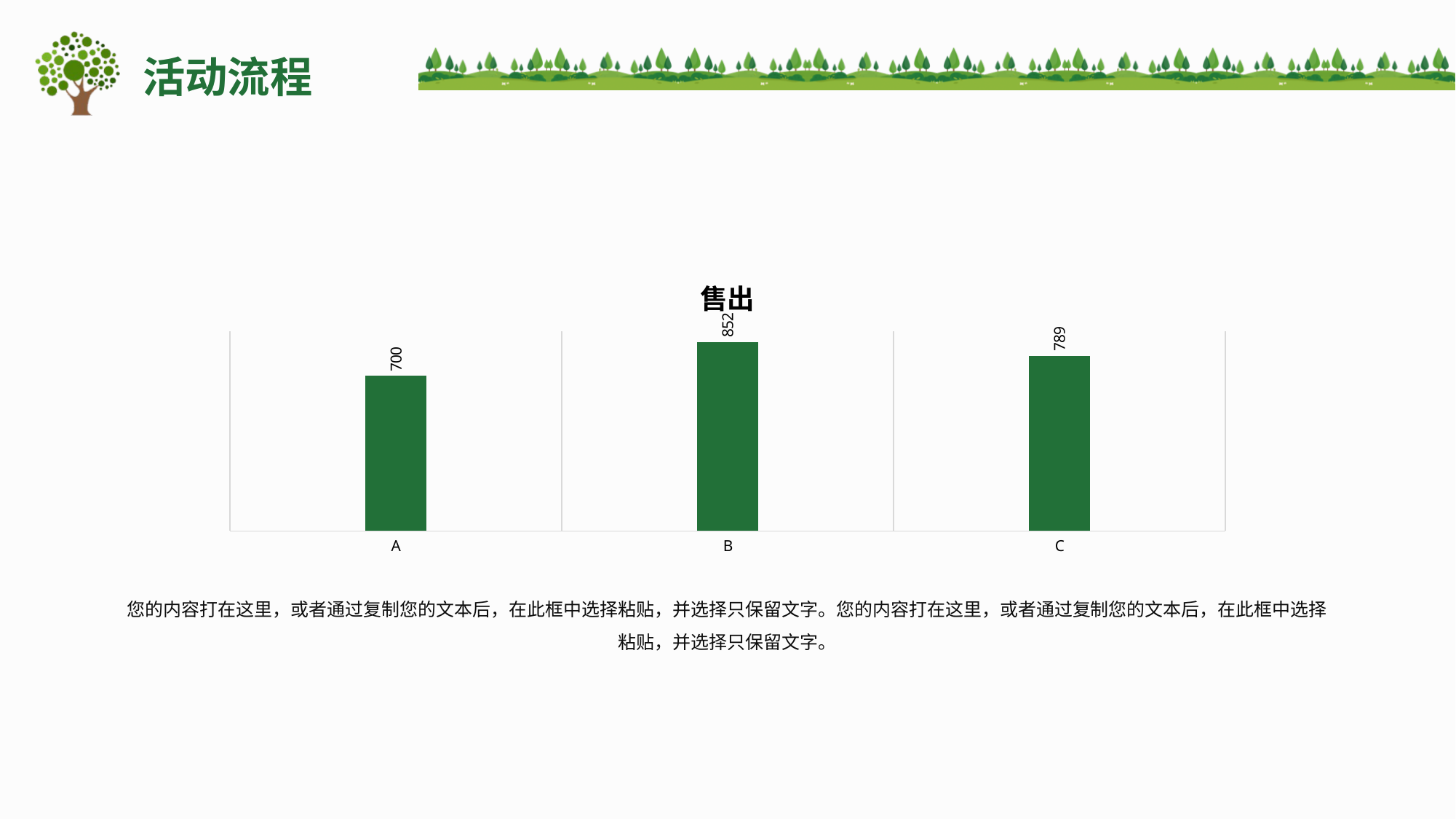
What is the value for category C? 789 Which is larger, the value for B or the value for C? B Which category has the highest value? B What is the title of the chart? 售出 What kind of chart is shown on the slide? bar chart What is the value for category B? 852 How many categories are shown in the chart? 3 What is the value for category A? 700 What is the difference between the values for C and A? 89 What is the difference between the values for B and C? 63 Which category has the lowest value? A What is the difference between the values for B and A? 152